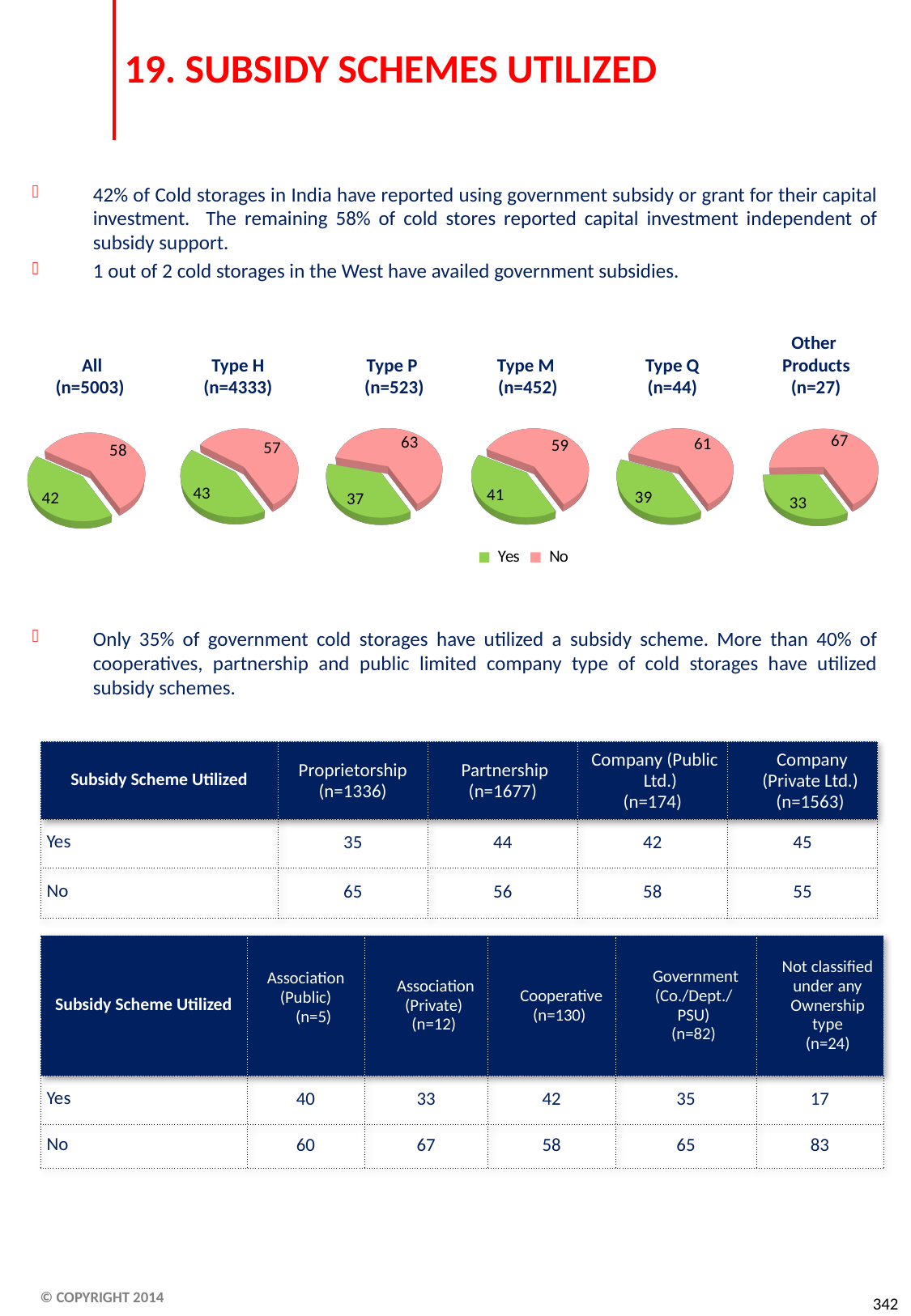
In the 'Type P (n=523)' pie chart, what is the value for Yes? 37 What kind of chart is used to show the subsidy utilization by type? Pie chart In the 'All (n=5003)' pie chart, what is the value for Yes? 42 Across the six pie charts, which group has the highest Yes value? Type H (n=4333) Across the six pie charts, which group has the lowest Yes value? Other Products (n=27) How many pie charts are shown on the slide? 6 In the 'Type H (n=4333)' pie chart, what is the value for No? 57 In the 'Type M (n=452)' pie chart, what is the difference between the No and Yes values? 18 In the 'Type Q (n=44)' pie chart, which slice is larger, Yes or No? No In the 'Other Products (n=27)' pie chart, what is the value for No? 67 How many series does the legend below the pie charts list? 2 In the pie charts, which colour represents Yes? Green